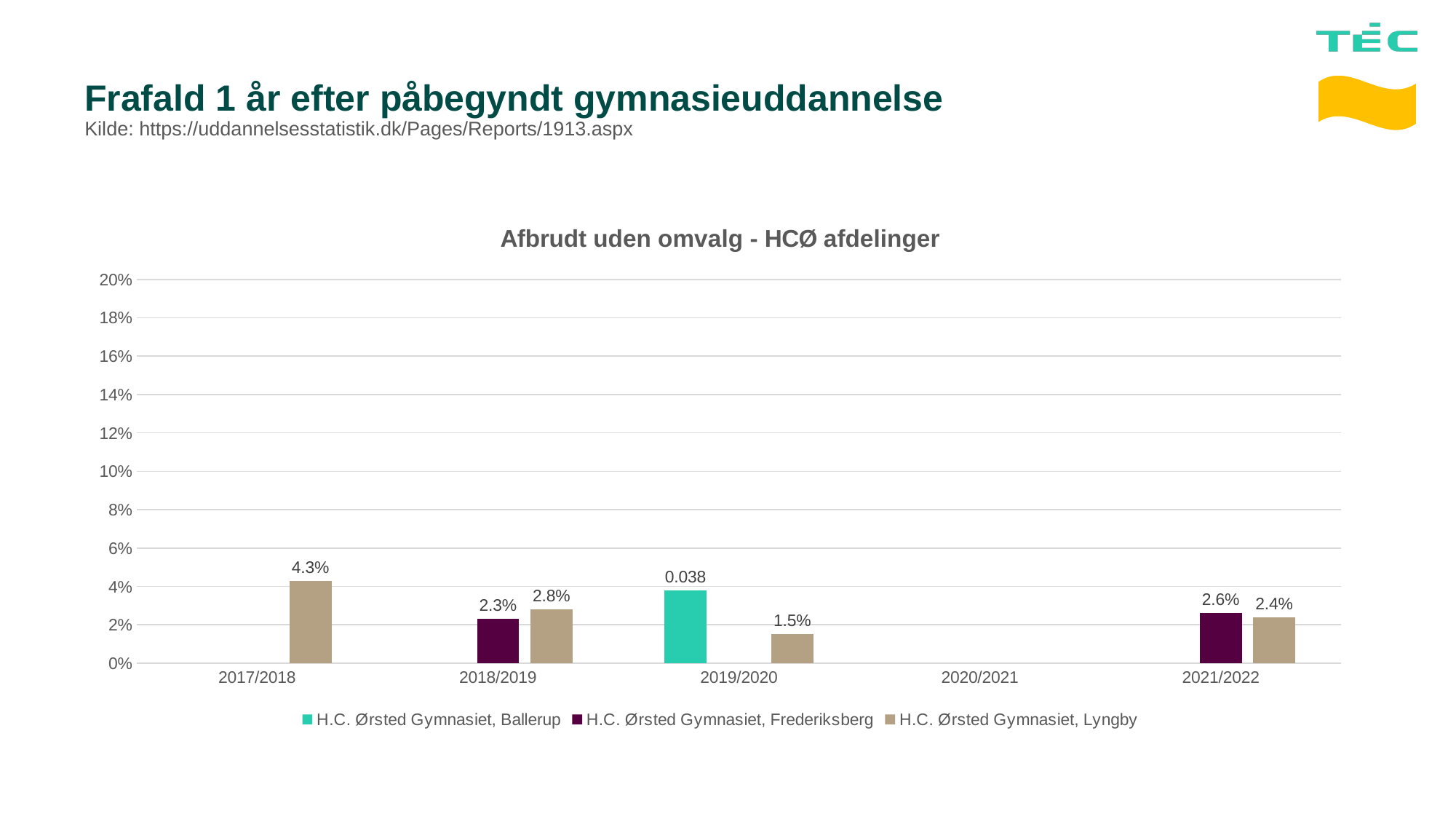
Is the value for H.C. Ørsted Gymnasiet, Lyngby in 2017/2018 greater or less than 4%? greater What is the difference between the Lyngby and Frederiksberg values in 2018/2019? 0.5 percentage points What data label is shown for H.C. Ørsted Gymnasiet, Ballerup in 2019/2020? 0.038 In which school year is the value for H.C. Ørsted Gymnasiet, Lyngby lowest? 2019/2020 What is the value for H.C. Ørsted Gymnasiet, Frederiksberg in 2018/2019? 2.3% In 2021/2022, which is larger: the value for Frederiksberg or the value for Lyngby? Frederiksberg What is the value for H.C. Ørsted Gymnasiet, Lyngby in 2021/2022? 2.4% What is the value for H.C. Ørsted Gymnasiet, Lyngby in 2017/2018? 4.3% In which school year is the value for H.C. Ørsted Gymnasiet, Lyngby highest? 2017/2018 How many school years are shown on the x axis? 5 What kind of chart is shown on the slide? Bar chart How many series does the legend list? 3